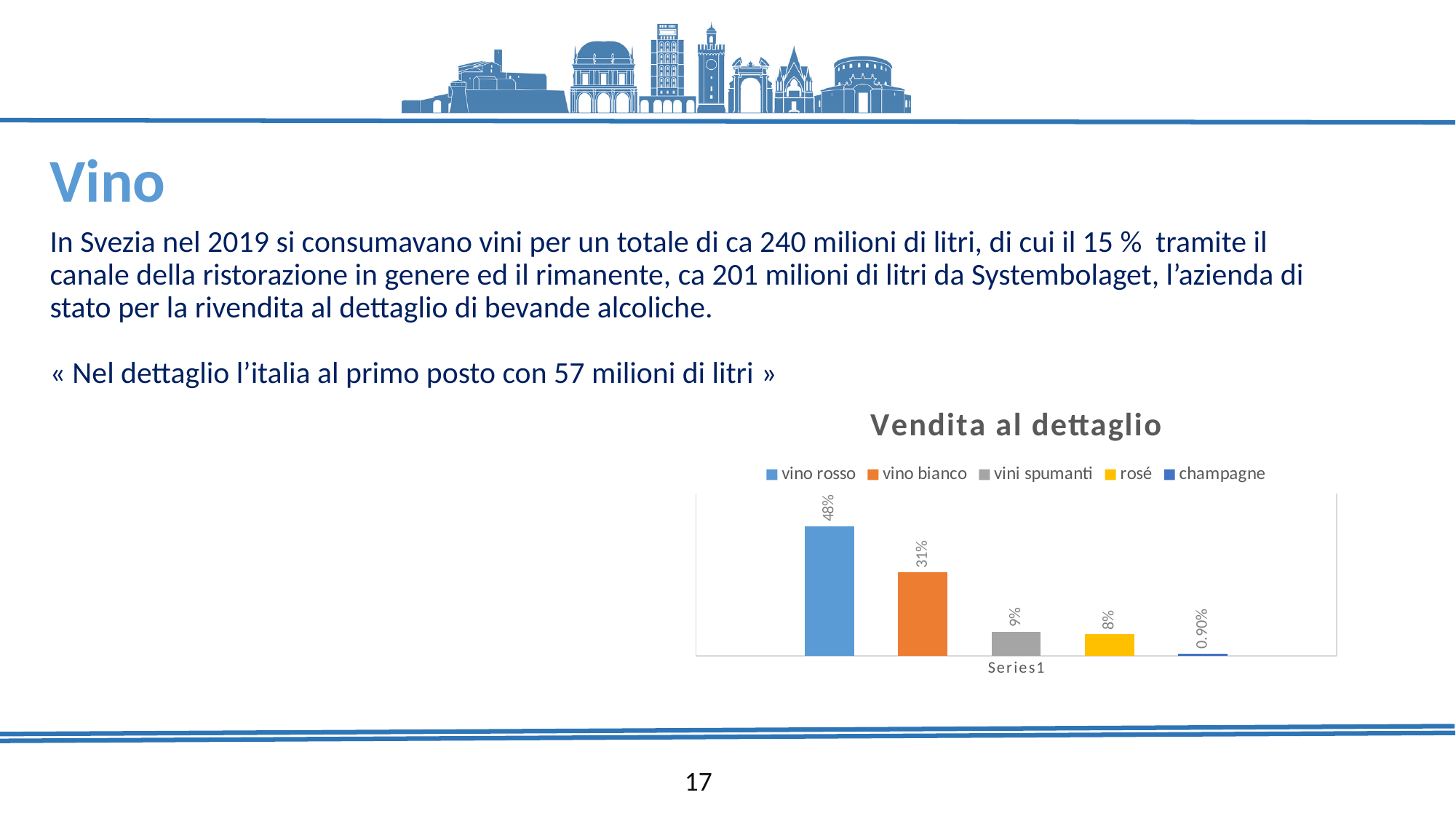
Which series has the highest value in the Vendita al dettaglio chart? vino rosso Which series has the lowest value in the Vendita al dettaglio chart? champagne What is the difference between the values for vino rosso and vino bianco in the Vendita al dettaglio chart? 17% What is the value for vino bianco in the Vendita al dettaglio chart? 31% What is the value for rosé in the Vendita al dettaglio chart? 8% What is the value for vino rosso in the Vendita al dettaglio chart? 48% What kind of chart is Vendita al dettaglio? bar chart What is the value for vini spumanti in the Vendita al dettaglio chart? 9% Which is larger in the Vendita al dettaglio chart, vini spumanti or rosé? vini spumanti How many series does the legend of the Vendita al dettaglio chart list? 5 What colour is the vino bianco bar in the Vendita al dettaglio chart? orange What is the value for champagne in the Vendita al dettaglio chart? 0.90%